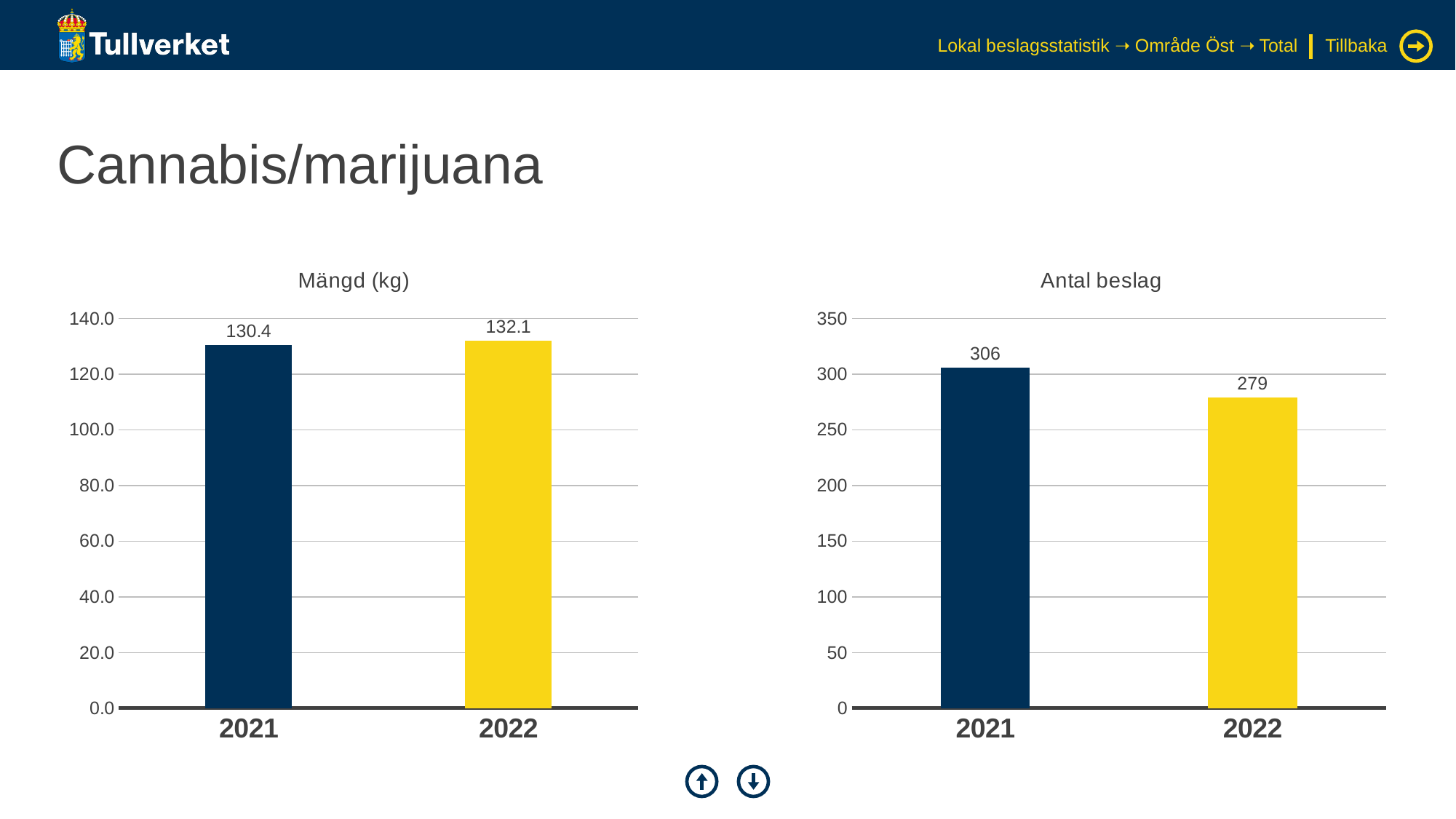
In the 'Mängd (kg)' chart, what is the value for 2022? 132.1 In the 'Mängd (kg)' chart, what is the value for 2021? 130.4 In the 'Antal beslag' chart, what is the value for 2021? 306 In the 'Antal beslag' chart, what is the value for 2022? 279 In the 'Mängd (kg)' chart, what is the difference between the 2022 and 2021 values? 1.7 In the 'Antal beslag' chart, do the values rise or fall from 2021 to 2022? fall In the 'Mängd (kg)' chart, which year has the lowest value? 2021 How many categories are shown on the x axis of the 'Mängd (kg)' chart? 2 In the 'Antal beslag' chart, which year has the highest value? 2021 What kind of chart is the 'Antal beslag' chart? bar chart In the 'Antal beslag' chart, what is the difference between the 2021 and 2022 values? 27 In the 'Antal beslag' chart, is the value for 2022 greater or less than 300? less